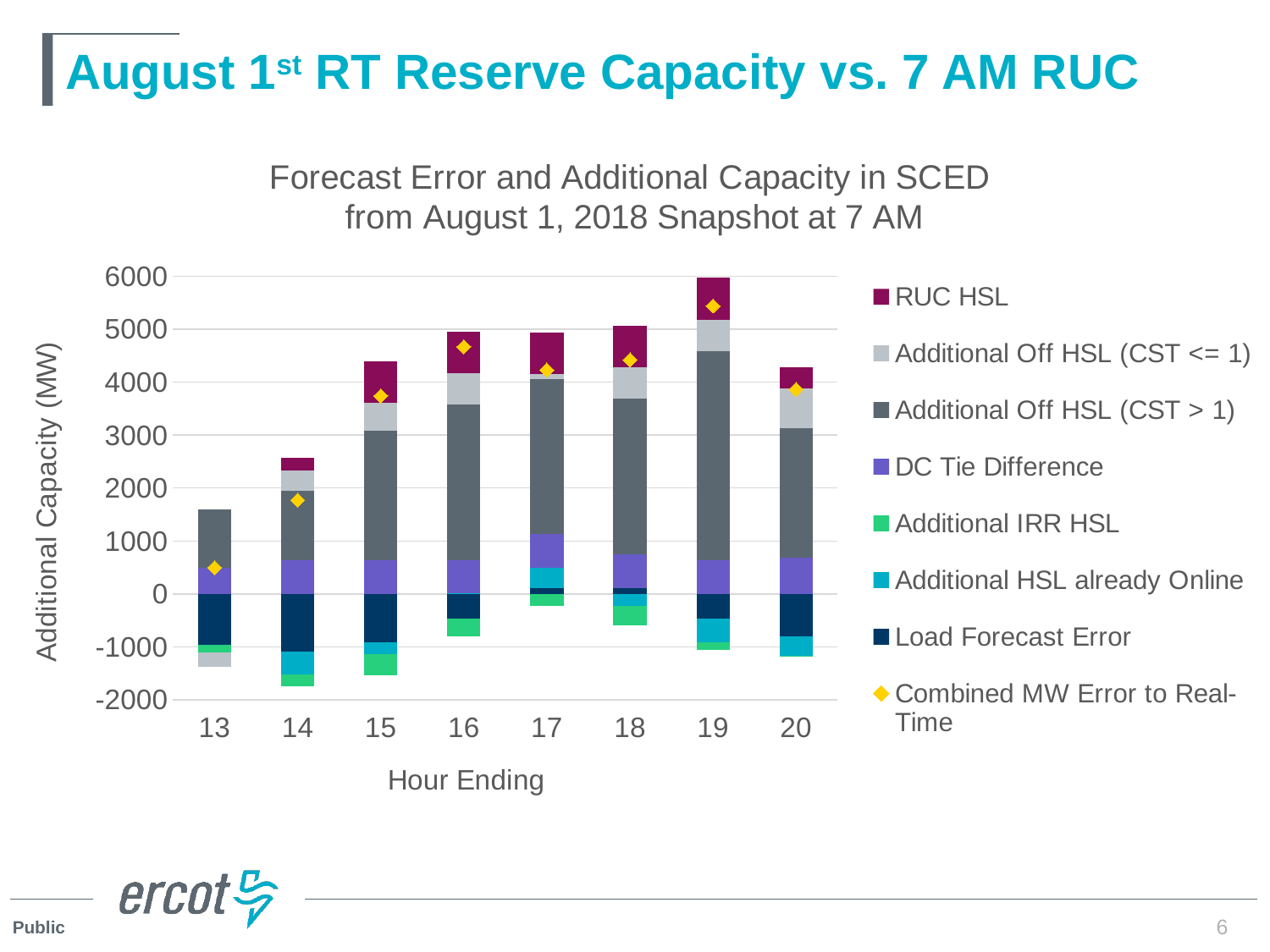
How many hour-ending categories are shown on the x axis? 8 What is the title of the x axis? Hour Ending Is the Combined MW Error to Real-Time value for hour ending 16 greater or less than 4000? greater At which hour ending is the Combined MW Error to Real-Time marker highest? 19 Does the Combined MW Error to Real-Time marker rise or fall from hour ending 13 to hour ending 16? rise What is the title of the y axis? Additional Capacity (MW) Is the Combined MW Error to Real-Time value for hour ending 19 greater or less than 5000? greater What kind of chart is shown on the slide? bar chart At which hour ending is the Combined MW Error to Real-Time marker lowest? 13 Which hour ending has the Combined MW Error to Real-Time marker higher, 16 or 17? 16 Is the Combined MW Error to Real-Time value for hour ending 13 greater or less than 1000? less How many series does the legend list? 8